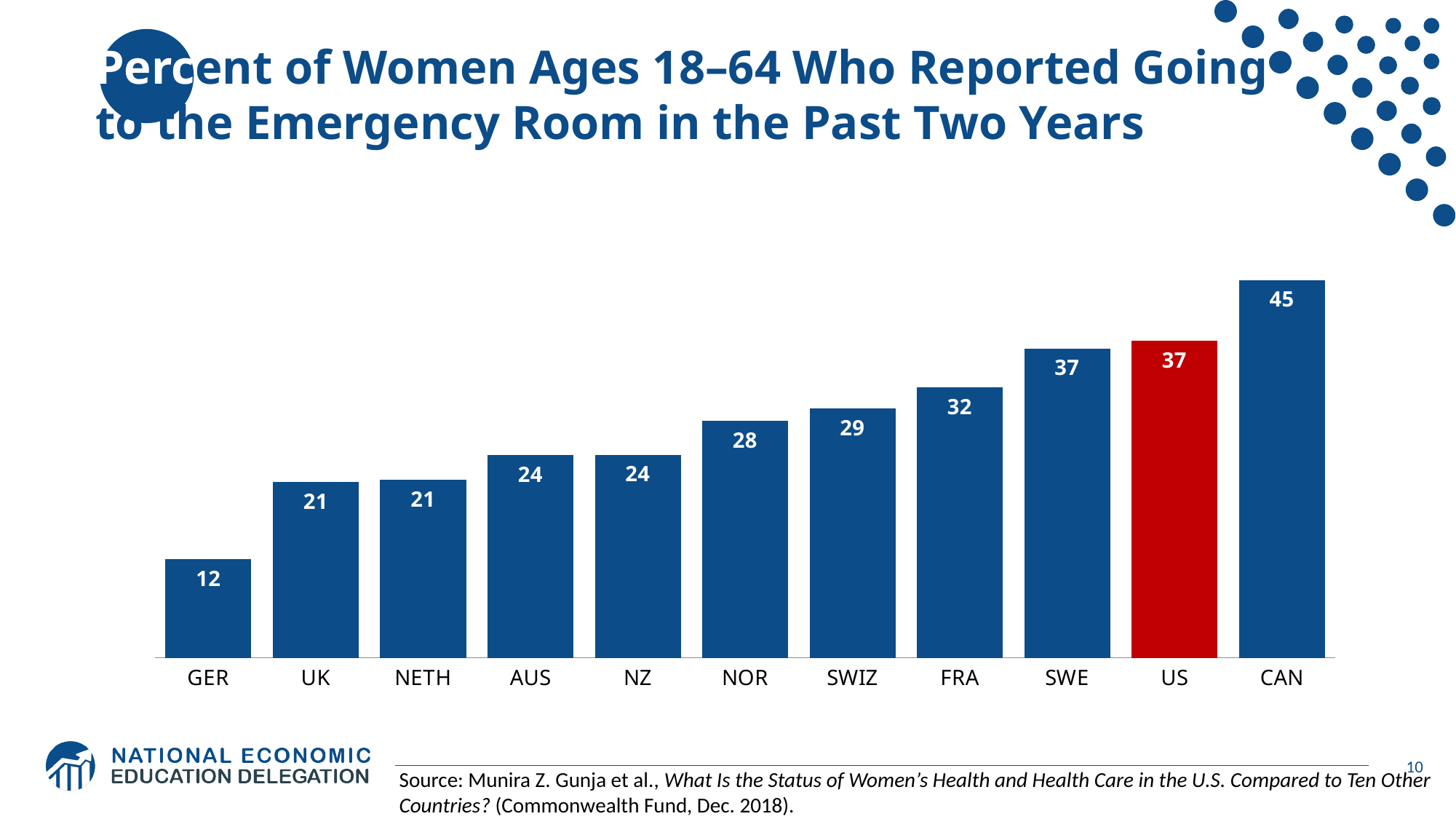
Which country has the lowest value? GER Do the values rise or fall from left to right across the chart? rise What is the difference between the values for FRA and UK? 11 Which country has the highest value? CAN What is the value for the US? 37 What is the difference between the values for CAN and the US? 8 What is the value for NOR? 28 Which bar is coloured red instead of blue? US Which is larger, the value for SWIZ or the value for AUS? SWIZ How many countries are shown on the chart? 11 What is the value for GER? 12 What kind of chart is this? bar chart